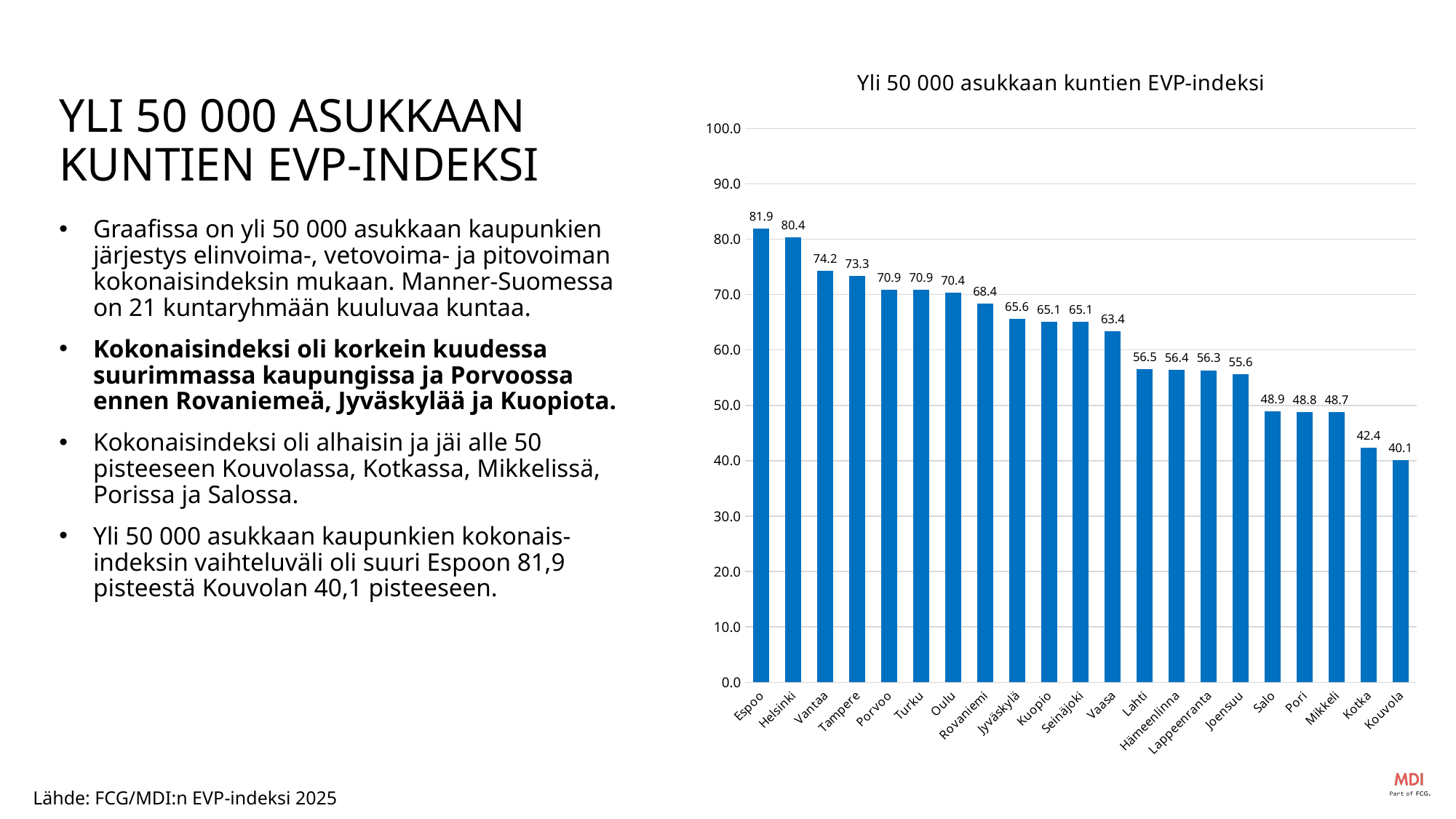
Is the value for Kotka greater or less than 50.0? less Which municipality has the lowest EVP index? Kouvola Which has a higher EVP index, Vaasa or Lahti? Vaasa Which municipality has the highest EVP index? Espoo What is the EVP index value for Lappeenranta? 56.3 What is the EVP index value for Rovaniemi? 68.4 What is the difference between the EVP index of Espoo and Kouvola? 41.8 What is the difference between the EVP index of Helsinki and Vantaa? 6.2 Do the values rise or fall from left to right along the x axis? Fall What is the EVP index value for Espoo? 81.9 What type of chart is shown on the slide? Bar chart How many municipalities are shown in the chart? 21